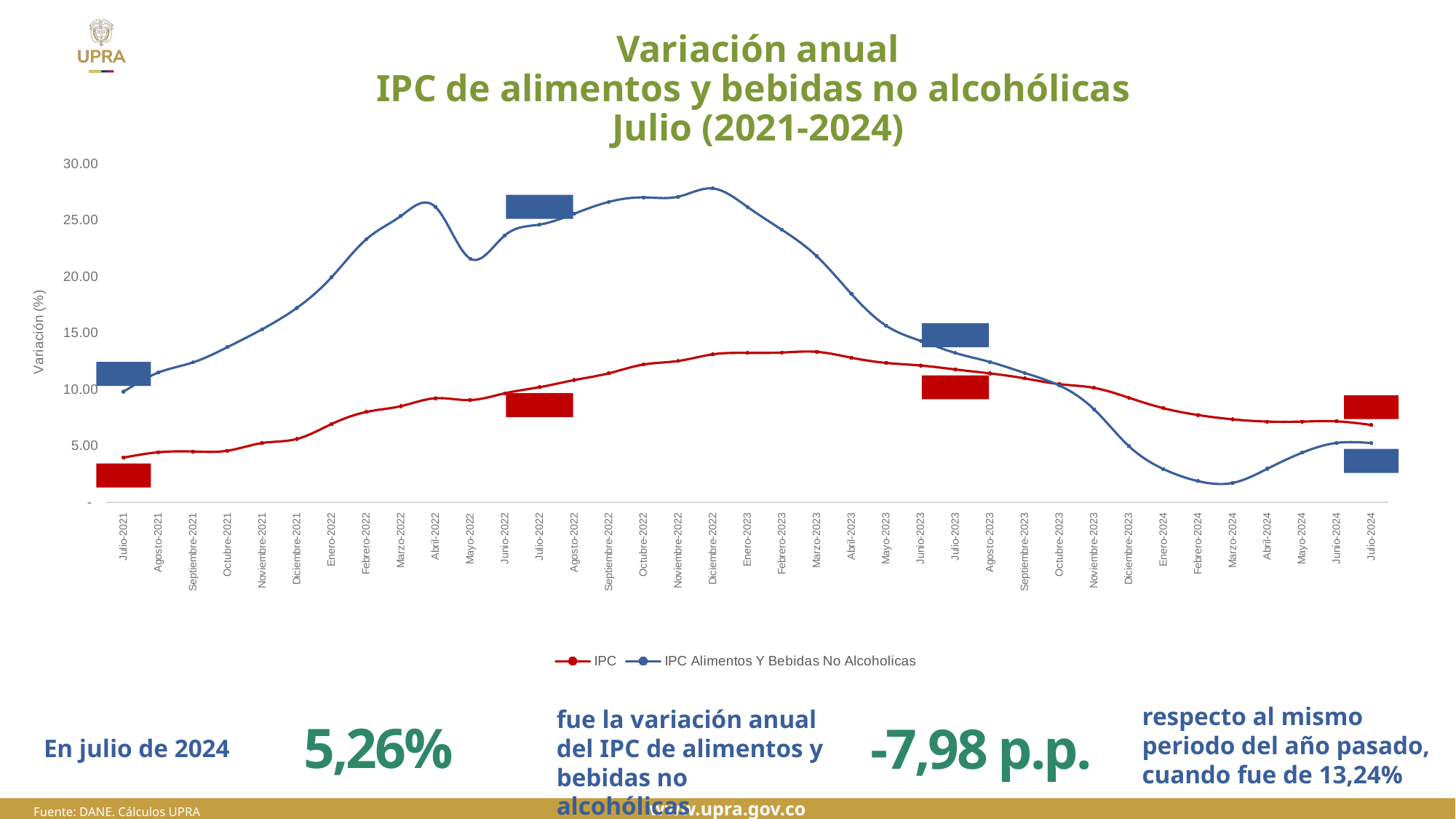
How many monthly points are plotted along the x axis, from Julio-2021 to Julio-2024? 37 According to the slide, what was the annual variation of the IPC de alimentos y bebidas no alcohólicas in July 2024? 5,26% In which month does the IPC Alimentos Y Bebidas No Alcoholicas series reach its highest value? Diciembre-2022 Is the value for IPC in Julio-2021 greater or less than 5.00? less How many series does the legend list? 2 Is the value for IPC in Diciembre-2022 greater or less than 10.00? greater In Julio-2022, which series has the higher value, IPC or IPC Alimentos Y Bebidas No Alcoholicas? IPC Alimentos Y Bebidas No Alcoholicas Does the IPC Alimentos Y Bebidas No Alcoholicas series rise or fall between Diciembre-2022 and Marzo-2024? fall Is the value for IPC Alimentos Y Bebidas No Alcoholicas in Diciembre-2022 greater or less than 25.00? greater In which month does the IPC series have its lowest value? Julio-2021 In Marzo-2024, which series has the higher value, IPC or IPC Alimentos Y Bebidas No Alcoholicas? IPC What kind of chart is shown on the slide? line chart